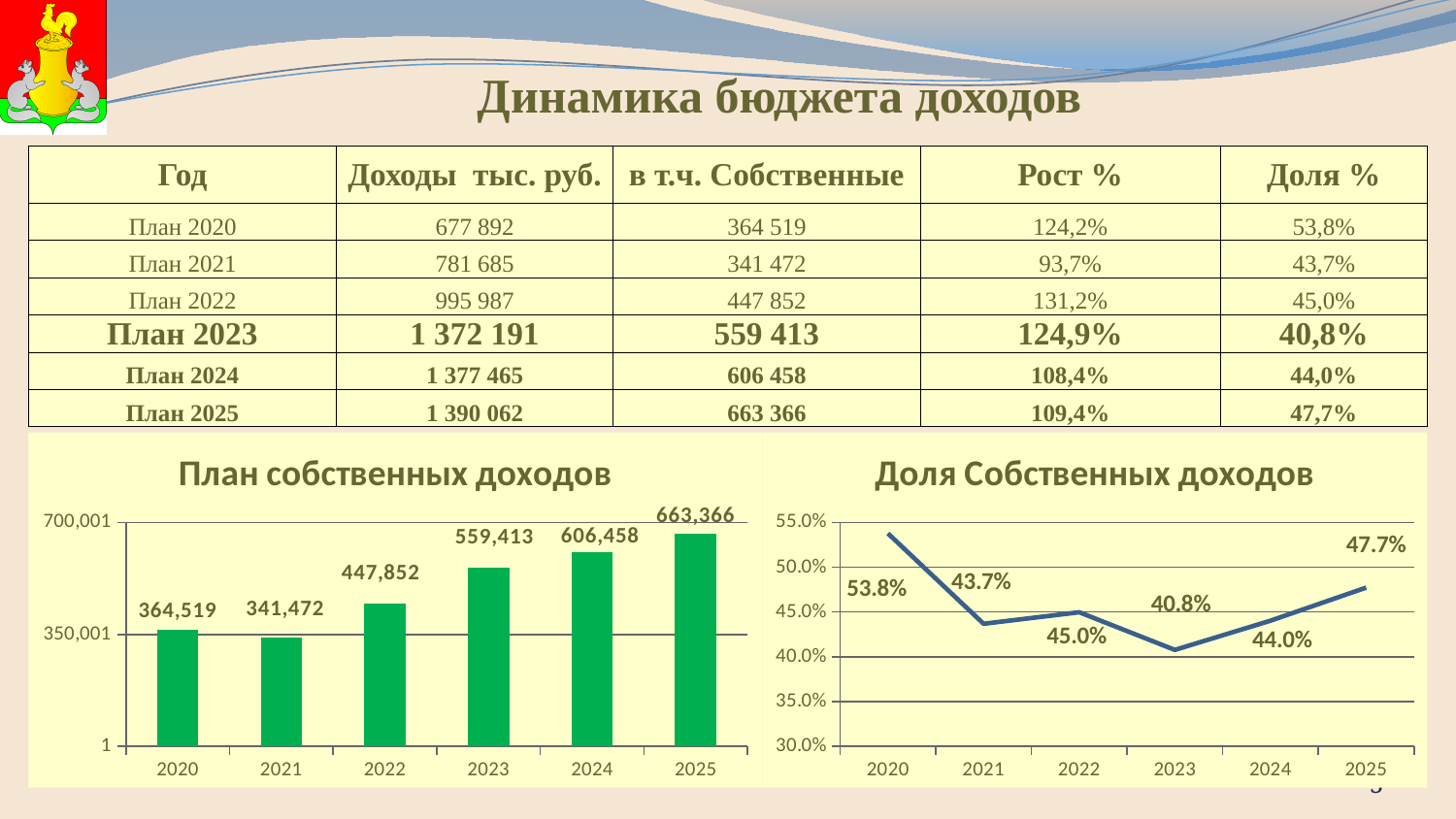
In the chart 'План собственных доходов', how many bars are plotted? 6 In the chart 'Доля Собственных доходов', what is the difference between the values for 2020 and 2023? 13.0% In the chart 'План собственных доходов', which year has the lowest value? 2021 In the chart 'Доля Собственных доходов', which year has the lowest value? 2023 In the chart 'План собственных доходов', what is the difference between the values for 2025 and 2024? 56,908 What kind of chart is 'План собственных доходов'? bar chart What kind of chart is 'Доля Собственных доходов'? line chart In the chart 'Доля Собственных доходов', is the value for 2021 larger or smaller than the value for 2025? smaller In the chart 'План собственных доходов', what is the value for 2023? 559,413 In the chart 'Доля Собственных доходов', what is the value for 2022? 45.0% In the chart 'План собственных доходов', which year has the highest value? 2025 In the chart 'Доля Собственных доходов', which year has the highest value? 2020